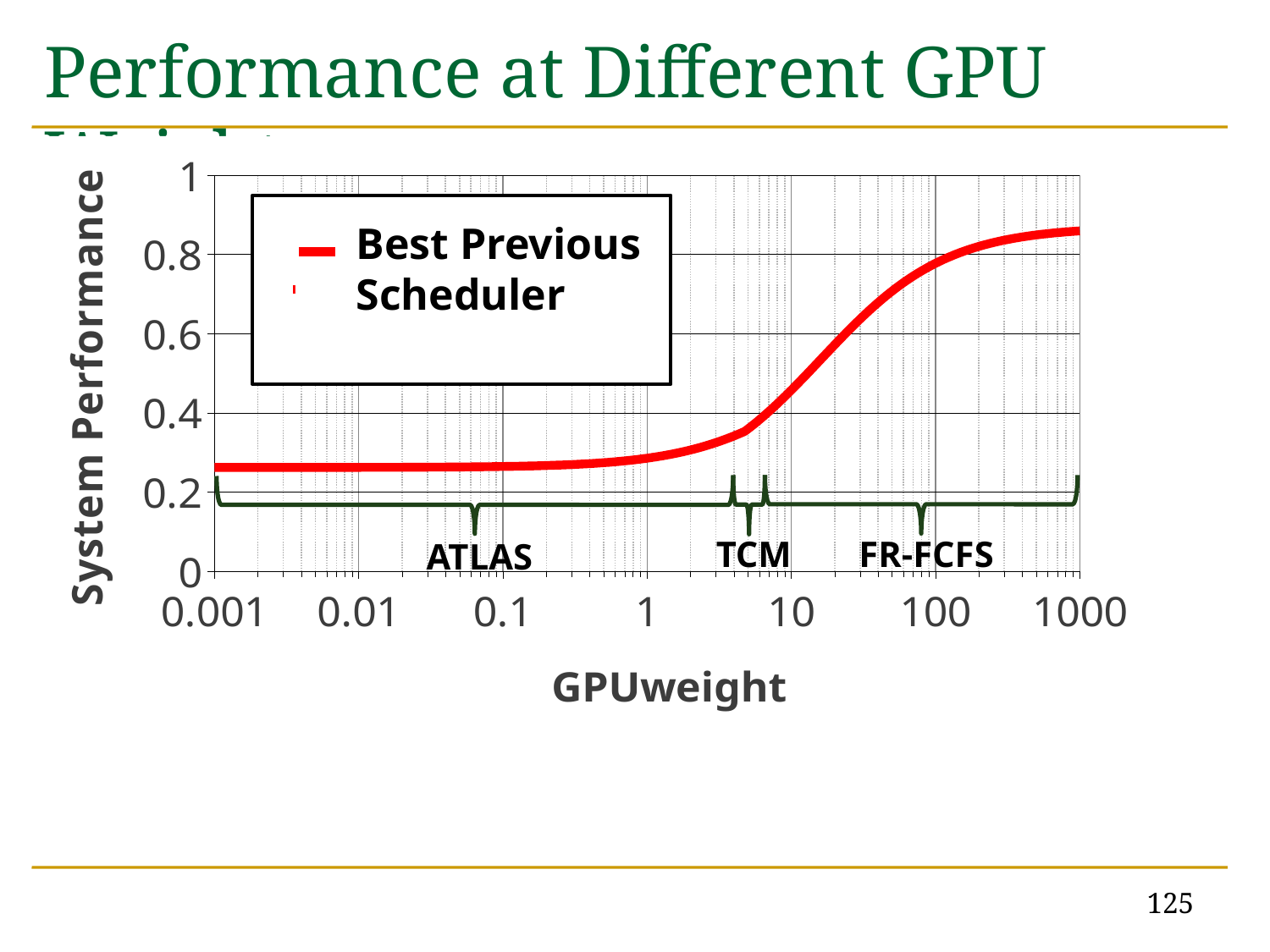
Is the System Performance of the Best Previous Scheduler at GPUweight 10 greater or less than 0.4? greater Is the System Performance of the Best Previous Scheduler at GPUweight 1 greater or less than 0.4? less What is the name of the series shown in the legend? Best Previous Scheduler Which is larger, the System Performance at GPUweight 0.01 or at GPUweight 100? GPUweight 100 What is the label of the x axis? GPUweight Does System Performance rise or fall as GPUweight increases from 0.001 to 1000? rise At which end of the GPUweight axis is System Performance highest, 0.001 or 1000? 1000 Is the System Performance of the Best Previous Scheduler at GPUweight 0.001 greater or less than 0.2? greater What kind of chart is shown on the slide? line chart How many series does the legend list? 1